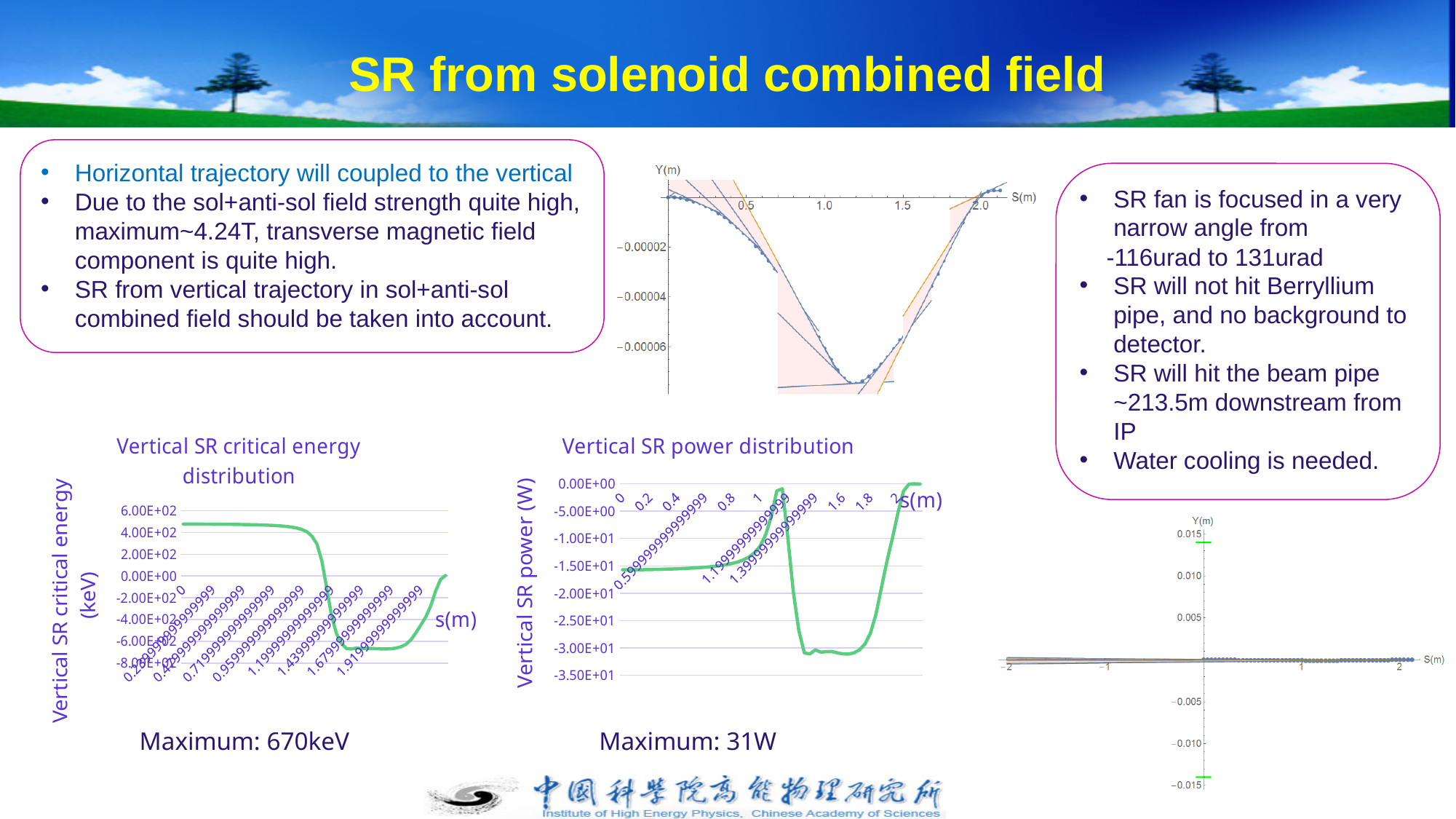
In the 'Vertical SR power distribution' chart, is the value at s = 1.4 greater or less than -2.50E+01? less In the 'Vertical SR critical energy distribution' chart, does the curve rise or fall between s = 0.96 and s = 1.44? fall In the 'Vertical SR power distribution' chart, is the value at s = 0 greater or less than -1.00E+01? less In the 'Vertical SR power distribution' chart, does the curve rise or fall between s = 1.6 and s = 2? rise What maximum value is stated below the 'Vertical SR critical energy distribution' chart? 670keV What maximum value is stated below the 'Vertical SR power distribution' chart? 31W In the top-centre Y(m) versus S(m) trajectory plot, is the lowest Y value greater or less than -0.00004? less What kind of chart is the 'Vertical SR critical energy distribution' chart? line chart In the 'Vertical SR power distribution' chart, which is larger: the value at s = 0 or the value at s = 1.4? s = 0 In the 'Vertical SR critical energy distribution' chart, which is larger: the value at s = 0 or the value at s = 1.68? s = 0